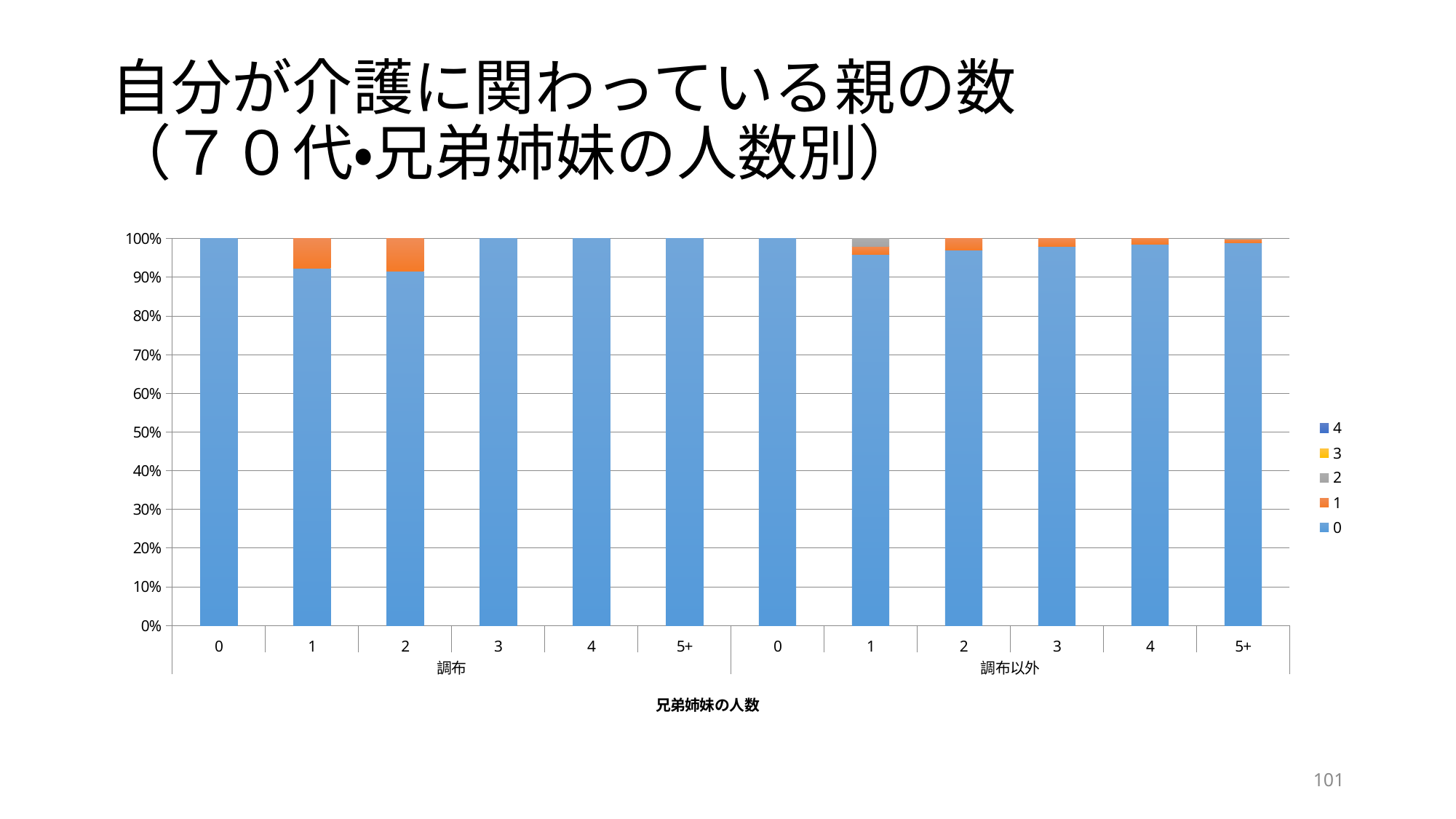
Which of the two bars, 調布 1 or 調布以外 1, has the larger "1" segment? 調布 1 How many bars are plotted in the chart? 12 How many bars are plotted in the 調布 group? 6 How many series does the legend list? 5 What is the total height of the bar for 調布 1 (the stacked bar reaches which axis value)? 100% Is the value of the "1" segment for 調布 2 greater or less than 20%? less Is the value of the "0" segment for 調布 1 greater or less than 80%? greater Which bar in the 調布 group has the smallest "0" segment? 2 What is the x-axis title of the chart? 兄弟姉妹の人数 What kind of chart is shown on the slide? Stacked bar chart Is the value of the "0" segment for 調布以外 2 greater or less than 90%? greater Which bar in the 調布以外 group shows a grey "2" segment? 1